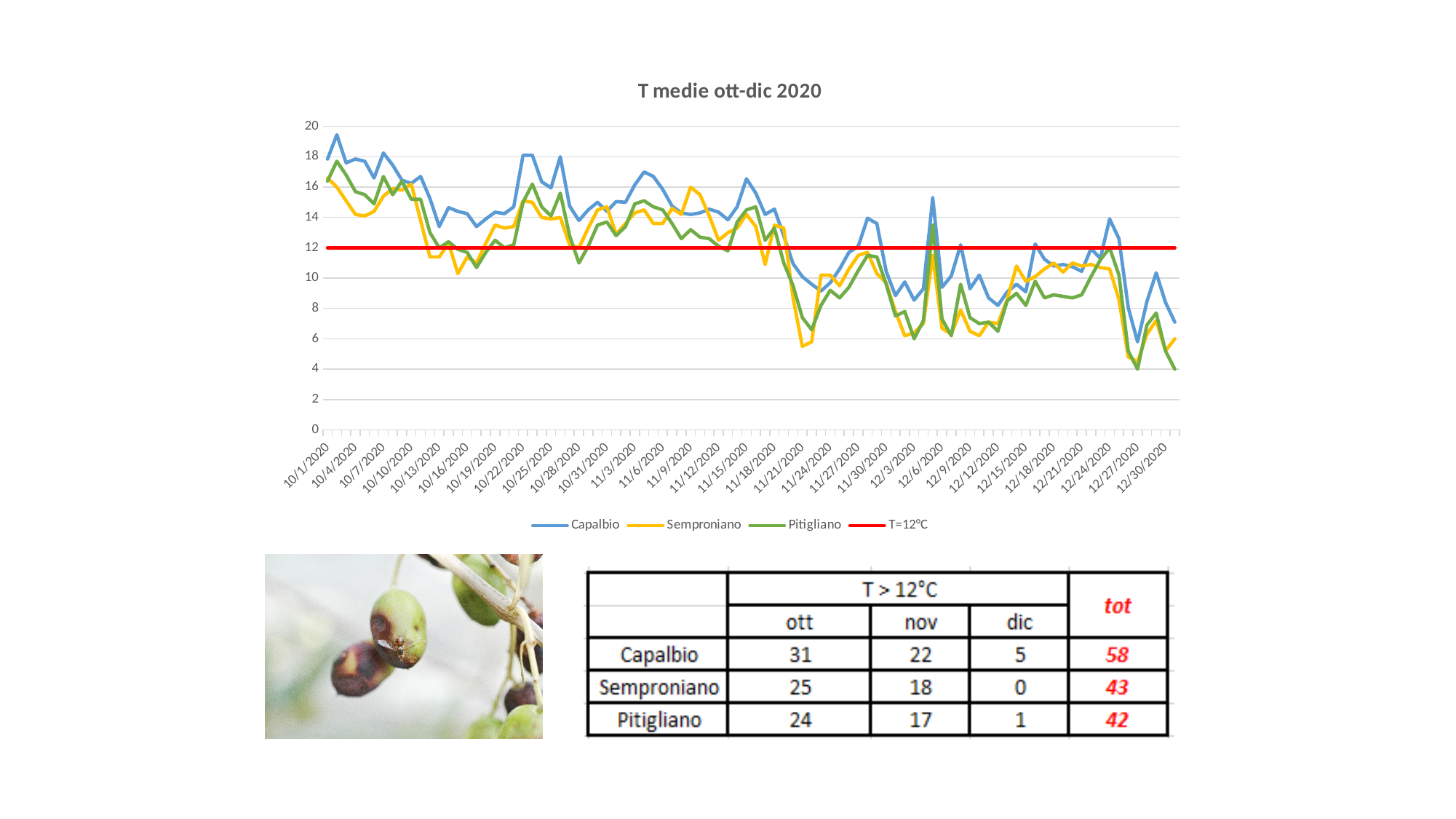
Do the temperature values generally rise or fall from October to December along the x axis? fall On 10/1/2020, which series has the higher value, Capalbio or Pitigliano? Capalbio What is the title of the chart? T medie ott-dic 2020 How many series does the chart legend list? 4 What kind of chart is shown on the slide? line chart Is the value for Pitigliano on 12/30/2020 greater or less than 6? less Is the value for Capalbio on 12/6/2020 greater or less than 14? less Is the value for Semproniano on 10/1/2020 greater or less than 18? less What temperature does the red horizontal reference line in the chart mark? 12 Which series stays highest for most of the period shown? Capalbio